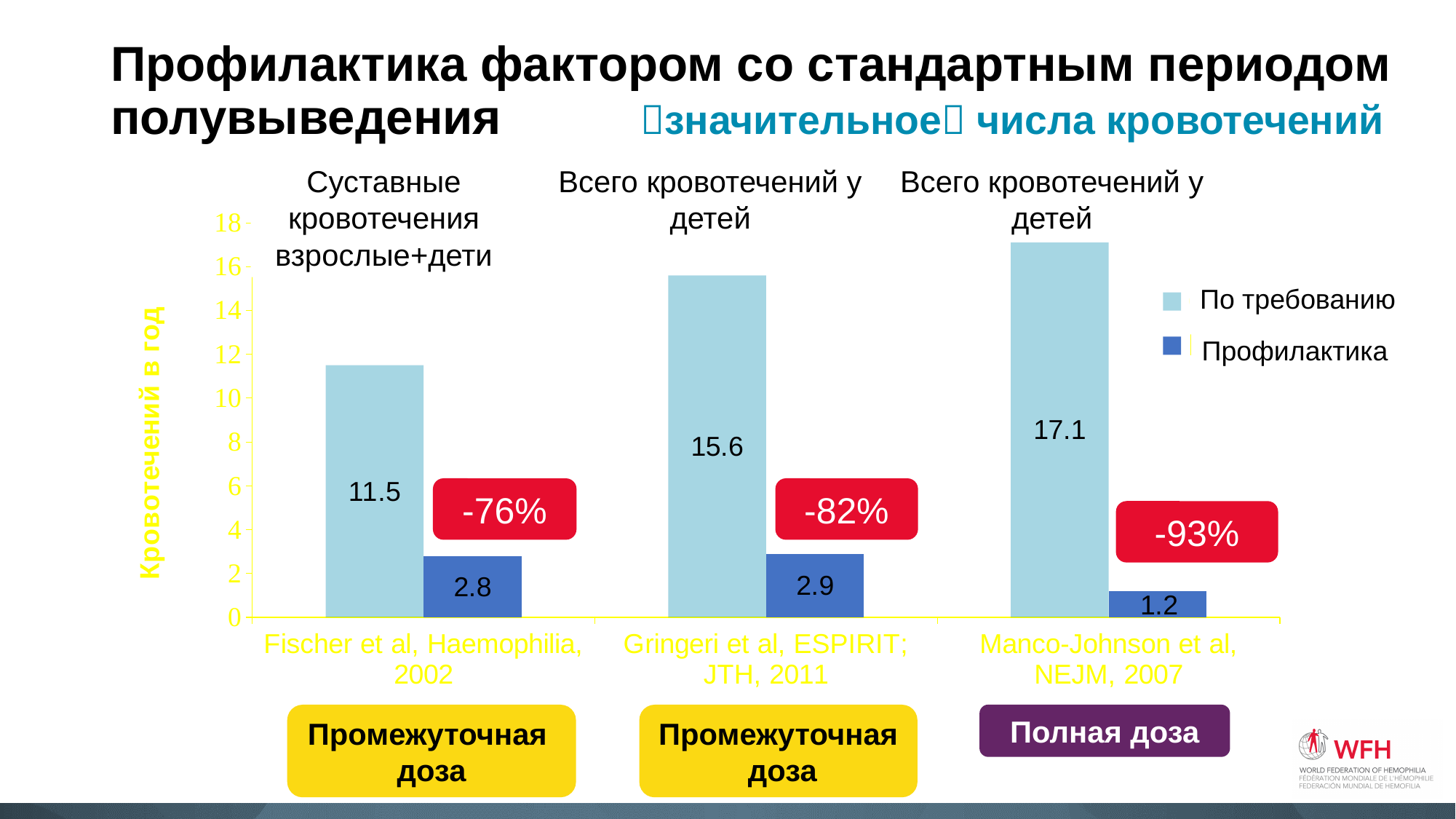
What kind of chart is shown on the slide? bar chart Which study has the lowest Профилактика value? Manco-Johnson et al, NEJM, 2007 What is the value for Профилактика in the Gringeri et al, ESPIRIT; JTH, 2011 study? 2.9 What percentage reduction is shown in the red box for the Manco-Johnson et al, NEJM, 2007 study? -93% How many series does the legend list? 2 What is the value for Профилактика in the Manco-Johnson et al, NEJM, 2007 study? 1.2 Which study has the highest По требованию value? Manco-Johnson et al, NEJM, 2007 What is the value for По требованию in the Fischer et al, Haemophilia, 2002 study? 11.5 Which is larger: the По требованию value for Fischer et al, Haemophilia, 2002 or for Gringeri et al, ESPIRIT; JTH, 2011? Gringeri et al, ESPIRIT; JTH, 2011 Is the По требованию value for Manco-Johnson et al, NEJM, 2007 greater or less than 16? greater How many studies (categories) are shown on the x axis? 3 What is the difference between the По требованию and Профилактика values for Gringeri et al, ESPIRIT; JTH, 2011? 12.7